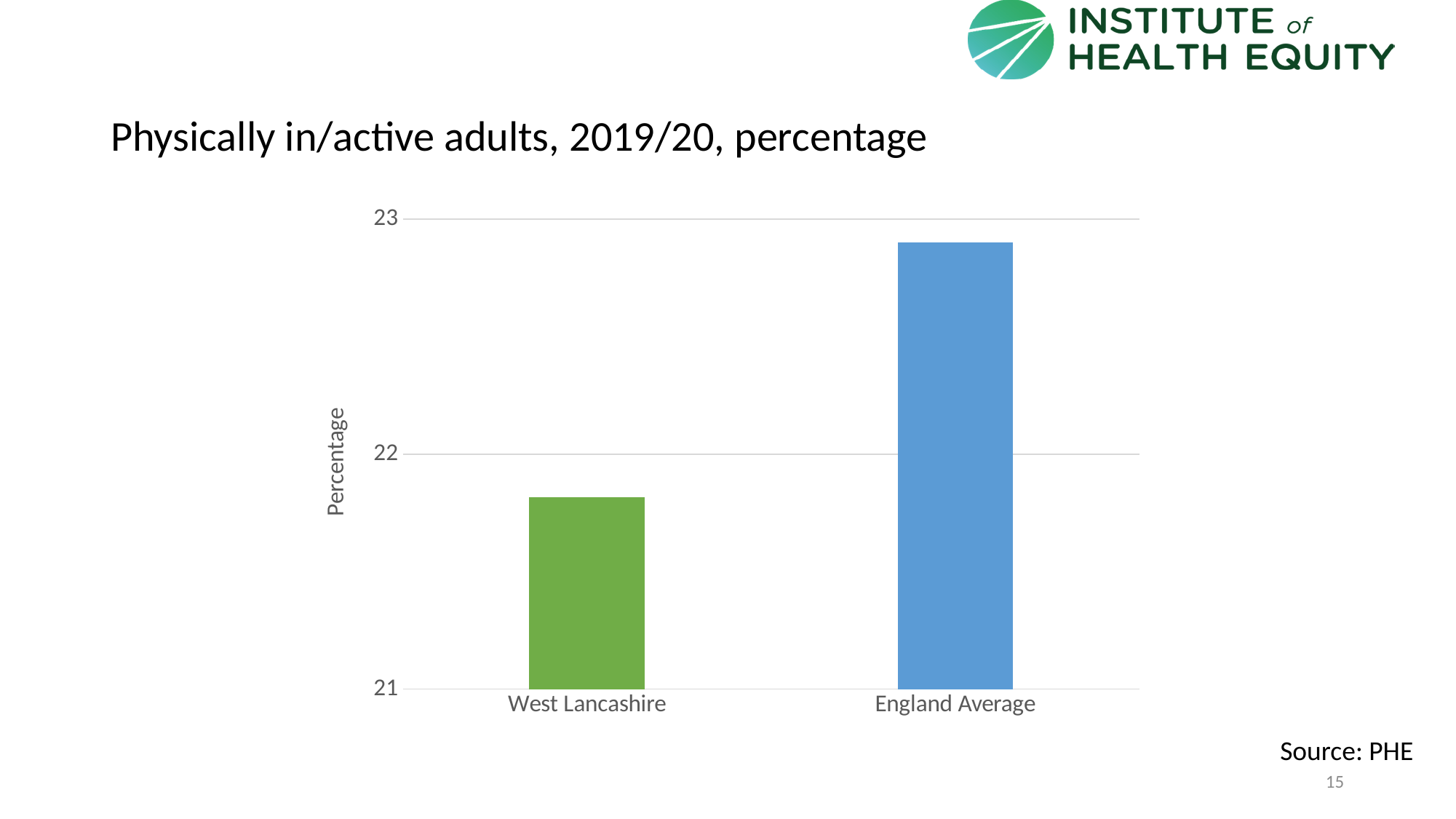
Which category has the lowest value? West Lancashire Which is larger, the value for West Lancashire or the value for England Average? England Average What kind of chart is shown on the slide? Bar chart What is the title of the chart? Physically in/active adults, 2019/20, percentage Is the value for England Average greater or less than 23? less Is the value for West Lancashire greater or less than 22? less What is the label on the vertical axis? Percentage Is the value for West Lancashire greater or less than 21? greater How many categories are plotted in the chart? 2 Which category has the highest value? England Average